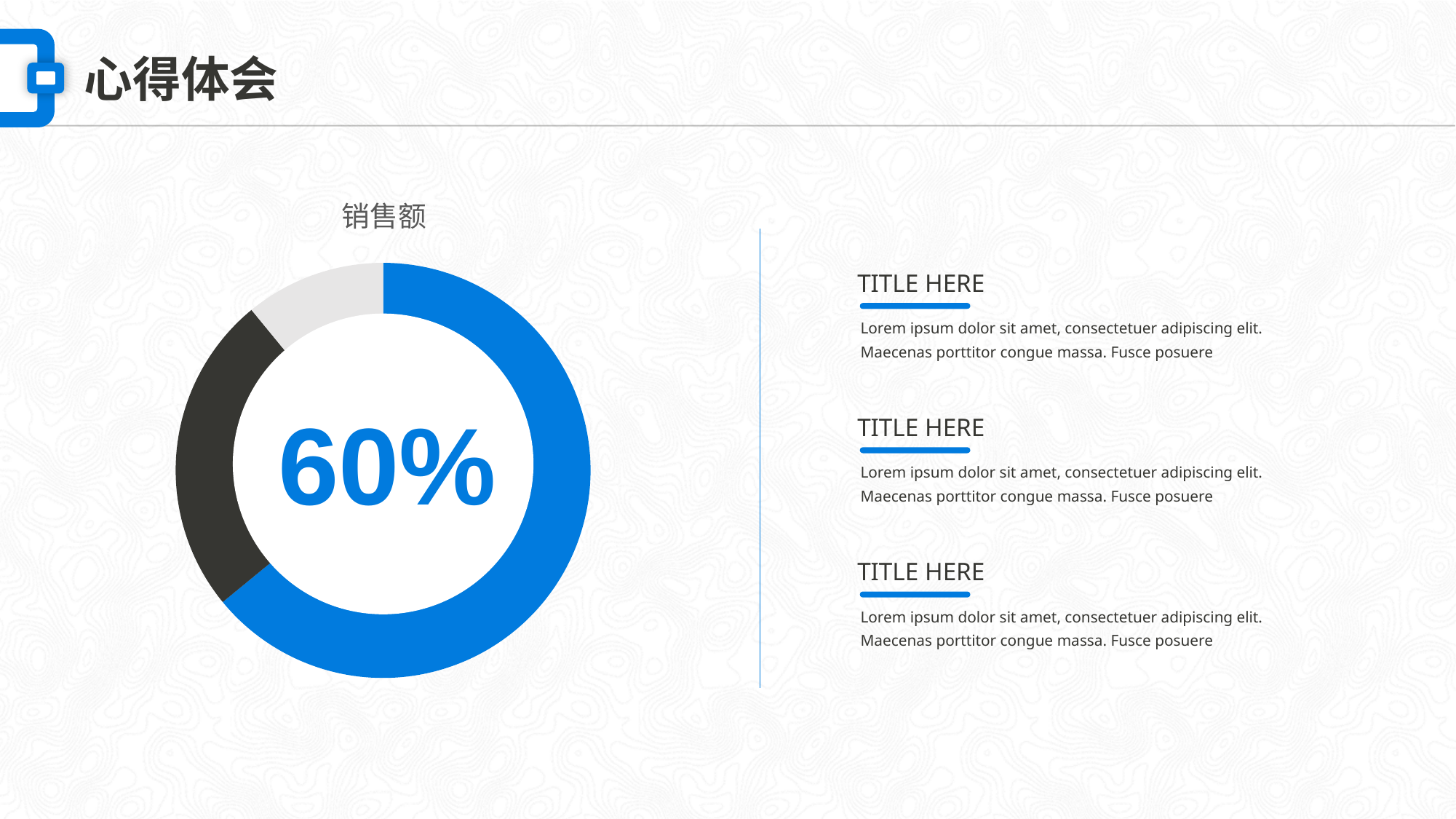
What kind of chart is shown on the slide? doughnut chart Which is larger, the blue slice or the dark gray slice? the blue slice How many slices does the doughnut chart have? 3 Which slice of the doughnut chart is the largest? the blue slice Which slice of the doughnut chart is the smallest? the light gray slice What colour is the largest slice of the doughnut chart? blue Which is larger, the dark gray slice or the light gray slice? the dark gray slice What is the title of the chart? 销售额 What percentage is printed in the centre of the doughnut chart? 60%